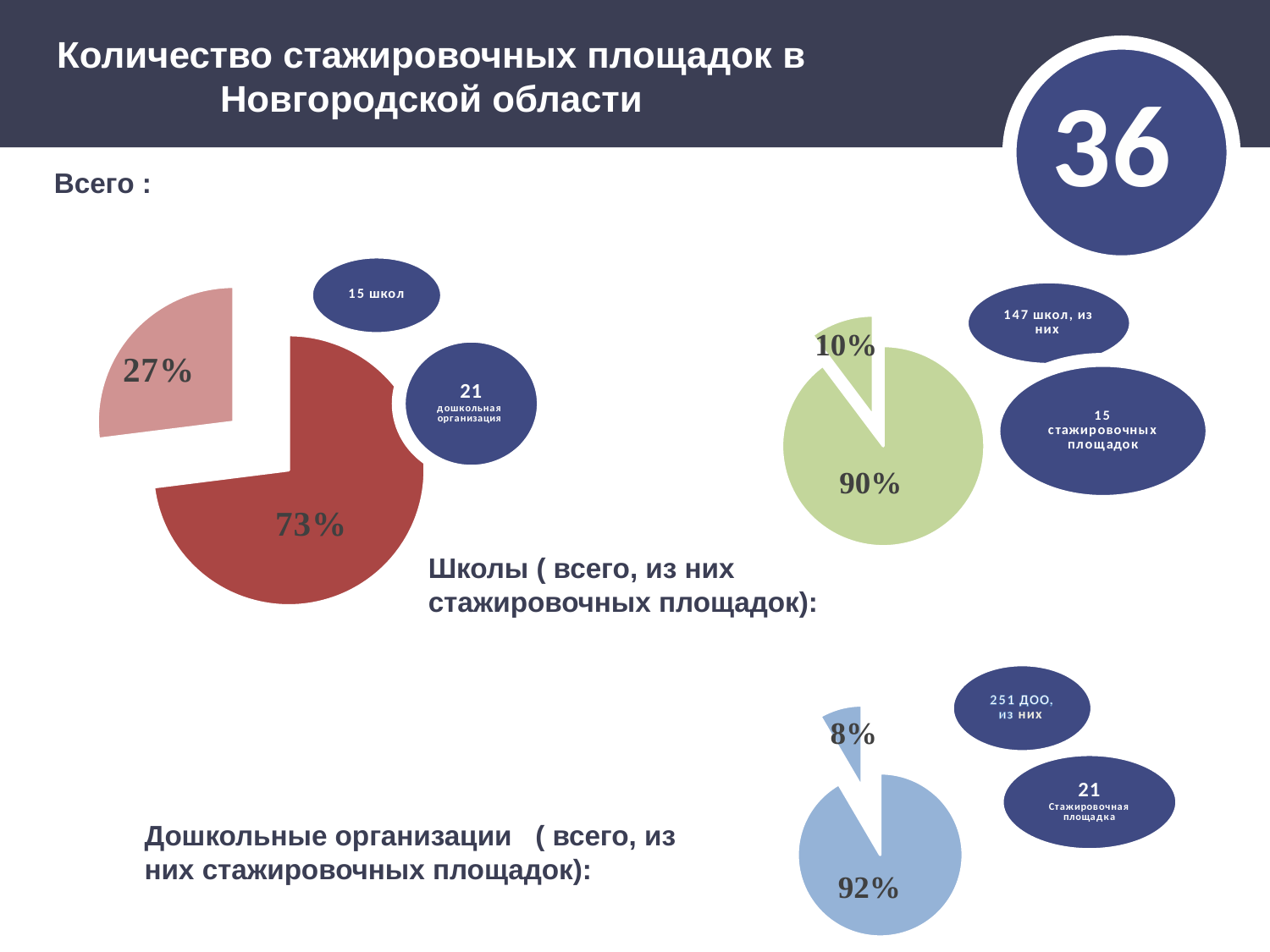
On the top-right pie chart (Школы), what share is shown for the larger slice? 90% On the bottom-right pie chart (Дошкольные организации), what share is shown for the larger slice? 92% On the bottom-right pie chart (Дошкольные организации), what share is shown for the smaller slice? 8% On the left pie chart (Всего), what is the difference in percentage points between the two slices? 46 What total number is shown in the large circle at the top right of the slide? 36 How many slices does the left pie chart (Всего) have? 2 Which is larger: the smaller slice of the top-right pie chart (Школы) or the smaller slice of the bottom-right pie chart (Дошкольные организации)? Top-right (Школы), 10% What kind of chart is used for the Школы data on the top right? Pie chart